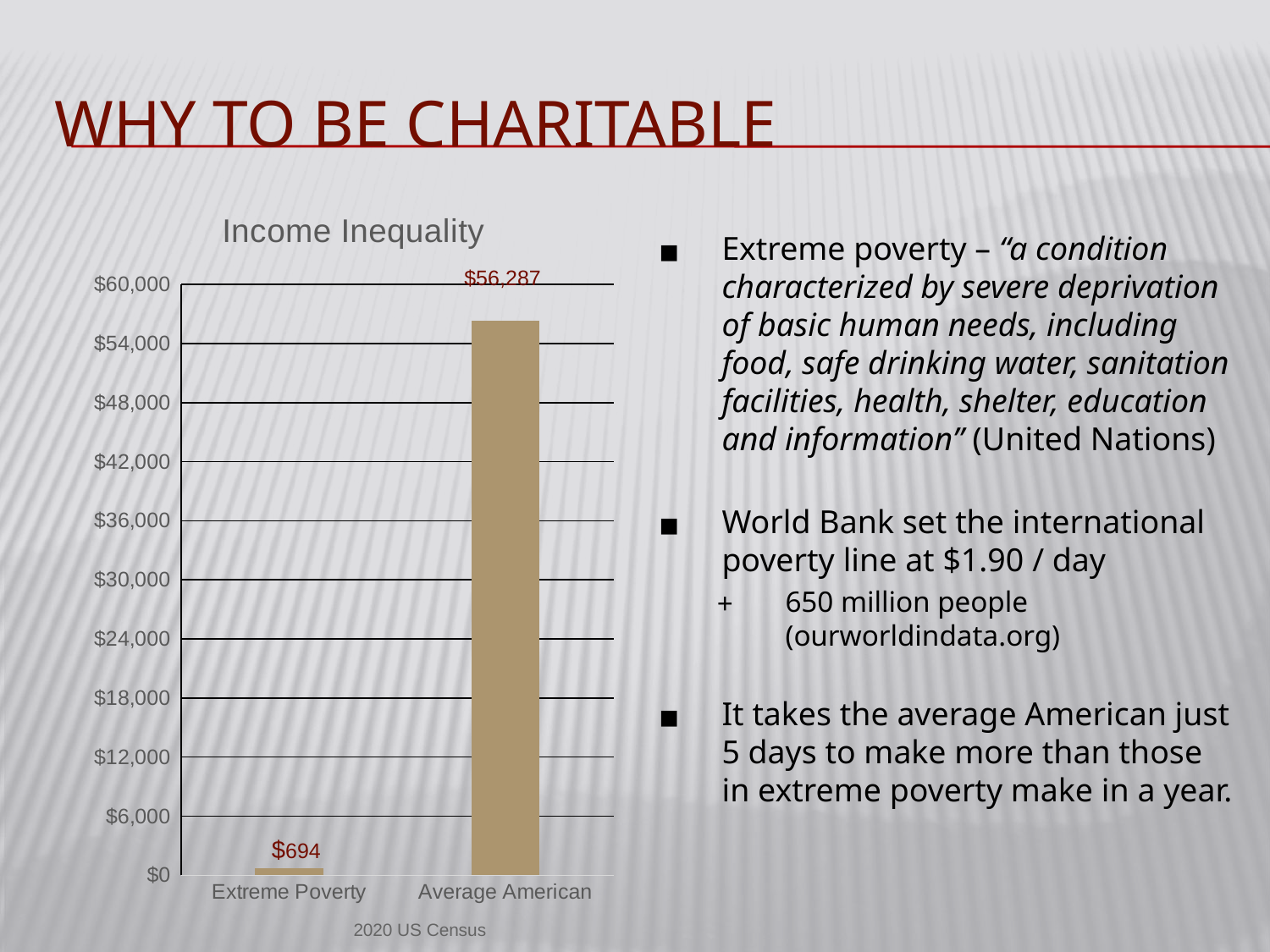
What kind of chart is the Income Inequality chart? bar chart What source is cited below the Income Inequality chart? 2020 US Census Is the value for Extreme Poverty greater or less than $6,000 in the Income Inequality chart? less What is the value for Extreme Poverty in the Income Inequality chart? $694 How many categories are shown in the Income Inequality chart? 2 Which category has the highest value in the Income Inequality chart? Average American Which is larger in the Income Inequality chart, Extreme Poverty or Average American? Average American Which category has the lowest value in the Income Inequality chart? Extreme Poverty What is the difference between the Average American and Extreme Poverty values in the Income Inequality chart? $55,593 What is the title of the chart on the slide? Income Inequality What is the value for Average American in the Income Inequality chart? $56,287 Is the value for Average American greater or less than $54,000 in the Income Inequality chart? greater